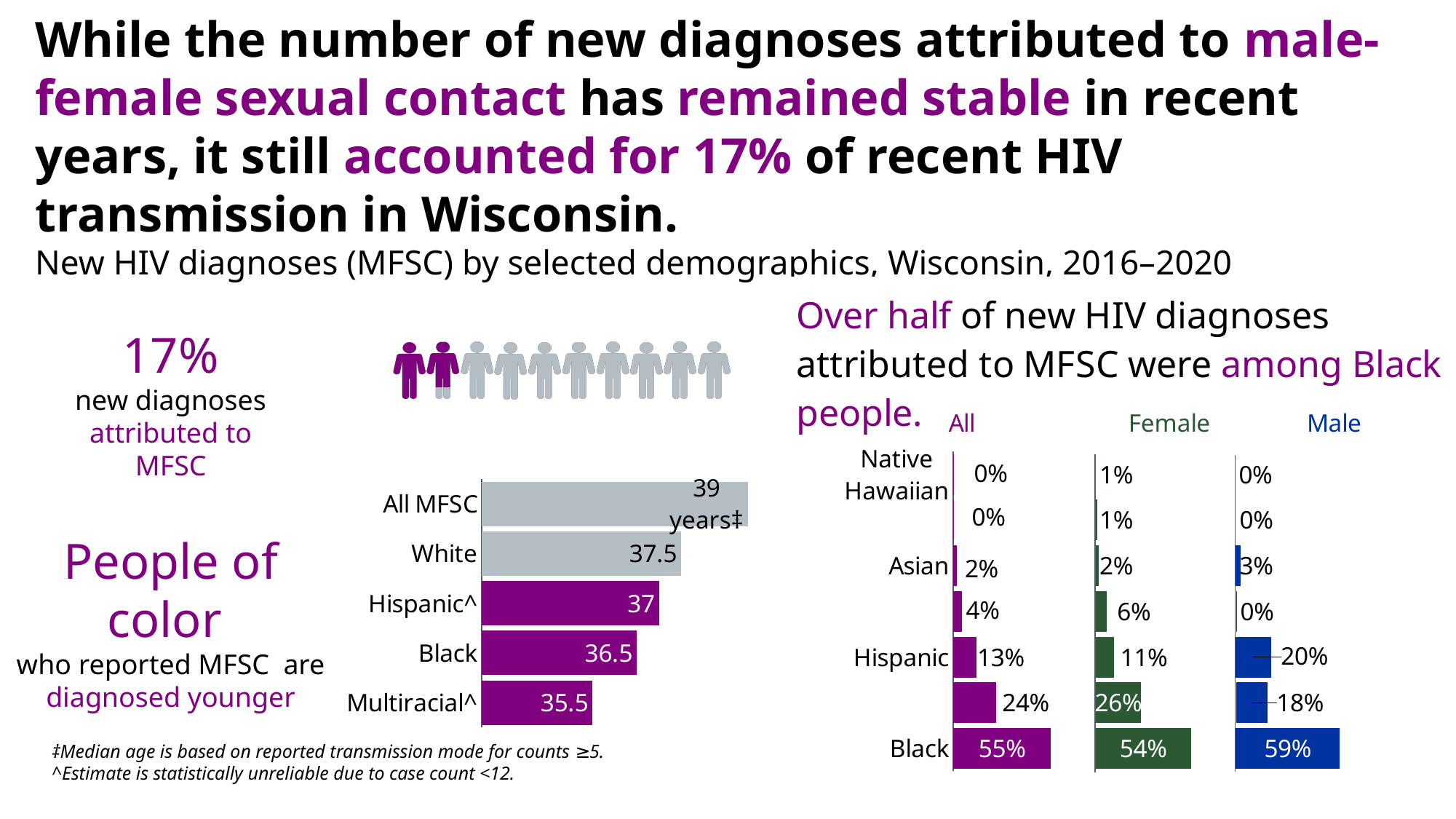
In the median age bar chart, which category has the highest value? All MFSC In the race/ethnicity chart on the right, how many series are shown? 3 In the median age bar chart, what is the value for White? 37.5 In the race/ethnicity chart on the right, what is the difference between the Male and Female values for Black? 5% In the median age bar chart, which category has the lowest value? Multiracial^ In the race/ethnicity chart on the right, which is larger for Hispanic: the All value or the Male value? Male What kind of chart is the median age chart? bar chart In the median age bar chart, what is the difference between the values for White and Multiracial^? 2 In the race/ethnicity chart on the right, what is the Male value for Black? 59% In the race/ethnicity chart on the right, what is the Female value for Hispanic? 11% In the median age bar chart, what is the value for Black? 36.5 In the median age bar chart, how many categories are shown? 5